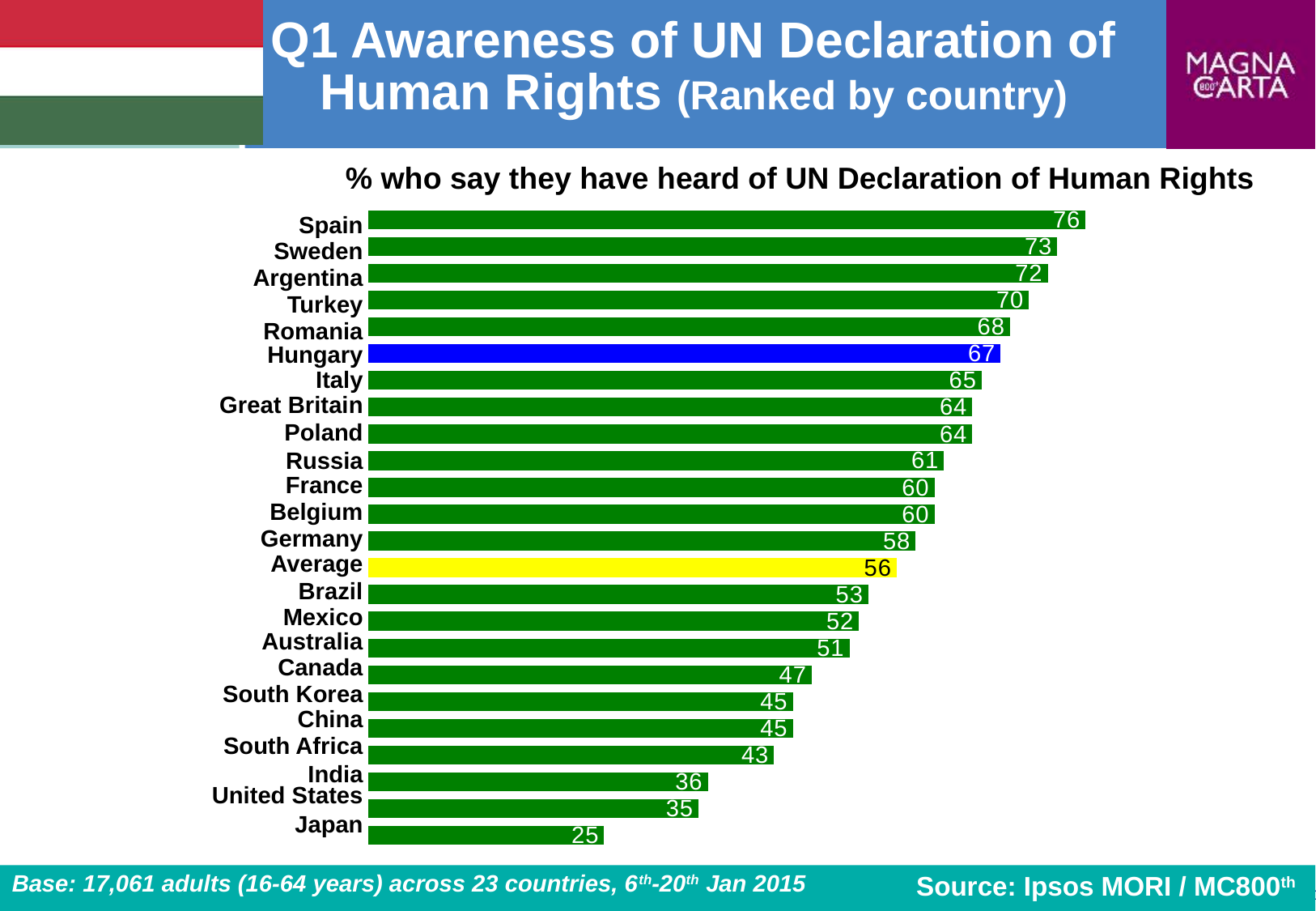
Which has a higher value, Canada or Brazil? Brazil What percentage of respondents in Hungary say they have heard of the UN Declaration of Human Rights? 67 What is the value shown for the Average bar? 56 How many bars are plotted in the chart, including the Average bar? 24 What is the difference between the values for Spain and Japan? 51 What is the value shown for Germany? 58 Which bar is coloured blue in the chart? Hungary Which country has the lowest percentage who say they have heard of the UN Declaration of Human Rights? Japan What type of chart is shown on the slide? Bar chart Which country has the highest percentage who say they have heard of the UN Declaration of Human Rights? Spain Which has a higher value, India or United States? India By how many points does Hungary exceed the Average? 11